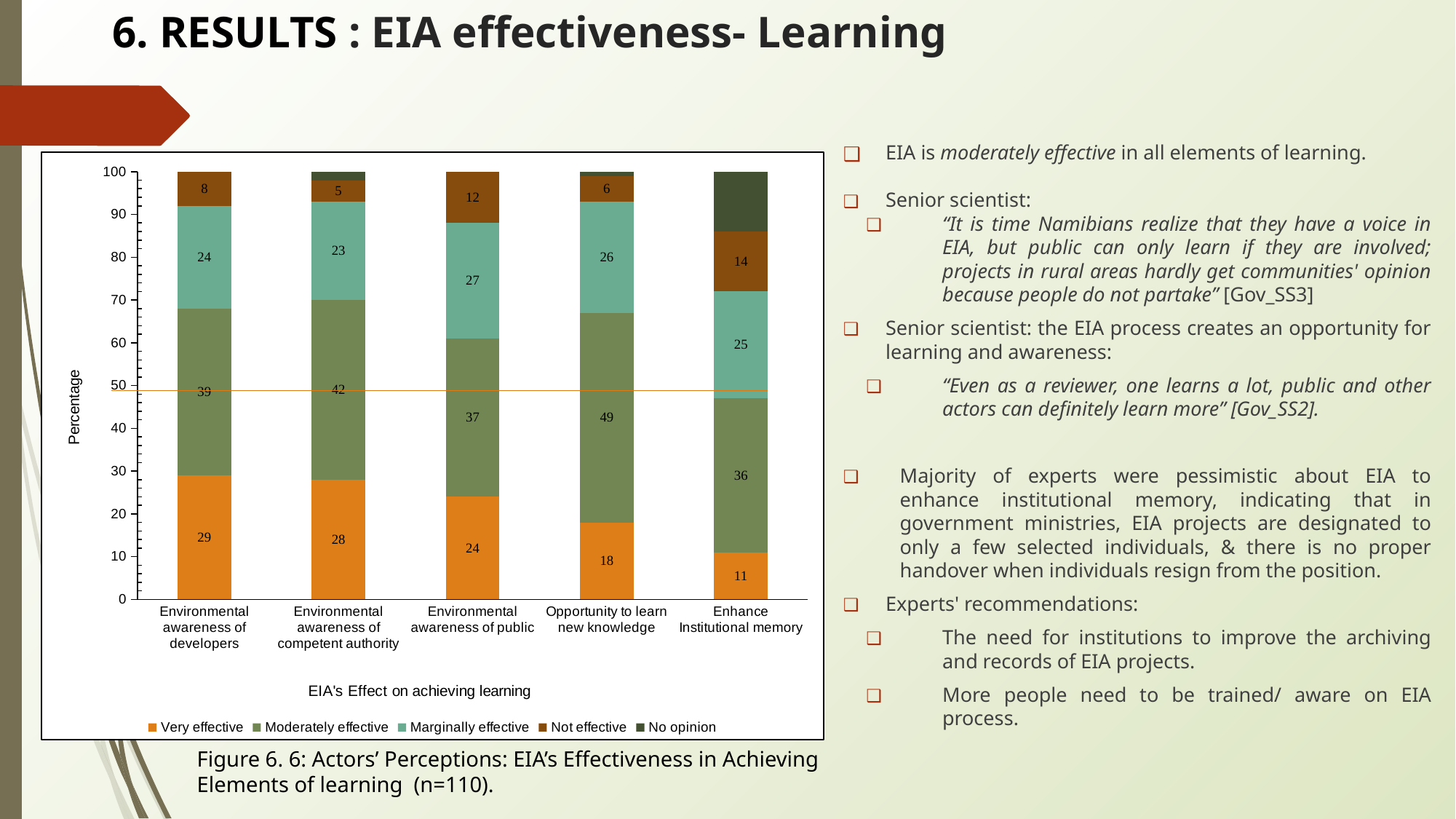
How many categories are shown on the x axis of the chart? 5 What type of chart is shown on the slide? stacked bar chart Which category has the lowest Very effective value? Enhance Institutional memory What is the label of the y axis of the chart? Percentage Which is larger: the Not effective value for Environmental awareness of public or for Environmental awareness of competent authority? Environmental awareness of public What is the difference between the Very effective values for Environmental awareness of developers and Enhance Institutional memory? 18 How many series does the chart legend list? 5 Which category has the highest Moderately effective value? Opportunity to learn new knowledge What is the Moderately effective value for Opportunity to learn new knowledge? 49 What is the Very effective value for Environmental awareness of developers? 29 What is the Not effective value for Enhance Institutional memory? 14 What is the Marginally effective value for Environmental awareness of public? 27